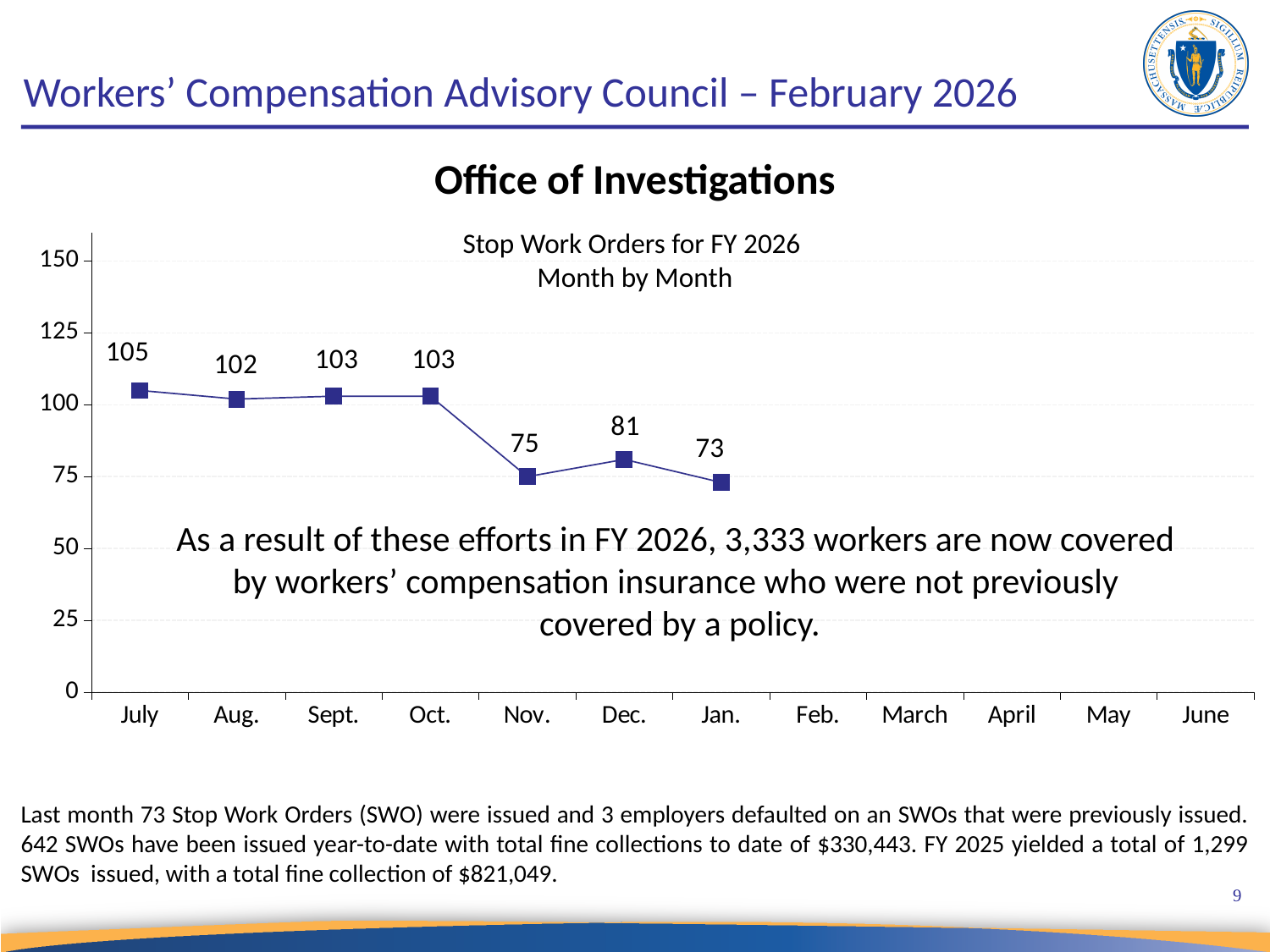
Which is larger in the Stop Work Orders for FY 2026 chart, the value for Aug. or the value for Dec.? Aug. What is the value for Dec. in the Stop Work Orders for FY 2026 chart? 81 Is the value for Jan. in the Stop Work Orders for FY 2026 chart greater or less than 100? less What is the value for Nov. in the Stop Work Orders for FY 2026 chart? 75 What is the difference between the values for Oct. and Nov. in the Stop Work Orders for FY 2026 chart? 28 How many months have plotted data points in the Stop Work Orders for FY 2026 chart? 7 What is the title of the chart on the slide? Stop Work Orders for FY 2026 Month by Month Which month has the lowest plotted value in the Stop Work Orders for FY 2026 chart? Jan. Which month has the highest value in the Stop Work Orders for FY 2026 chart? July Do the values in the Stop Work Orders for FY 2026 chart generally rise or fall from July to Jan.? fall What is the value for July in the Stop Work Orders for FY 2026 chart? 105 What kind of chart is the Stop Work Orders for FY 2026 chart? line chart